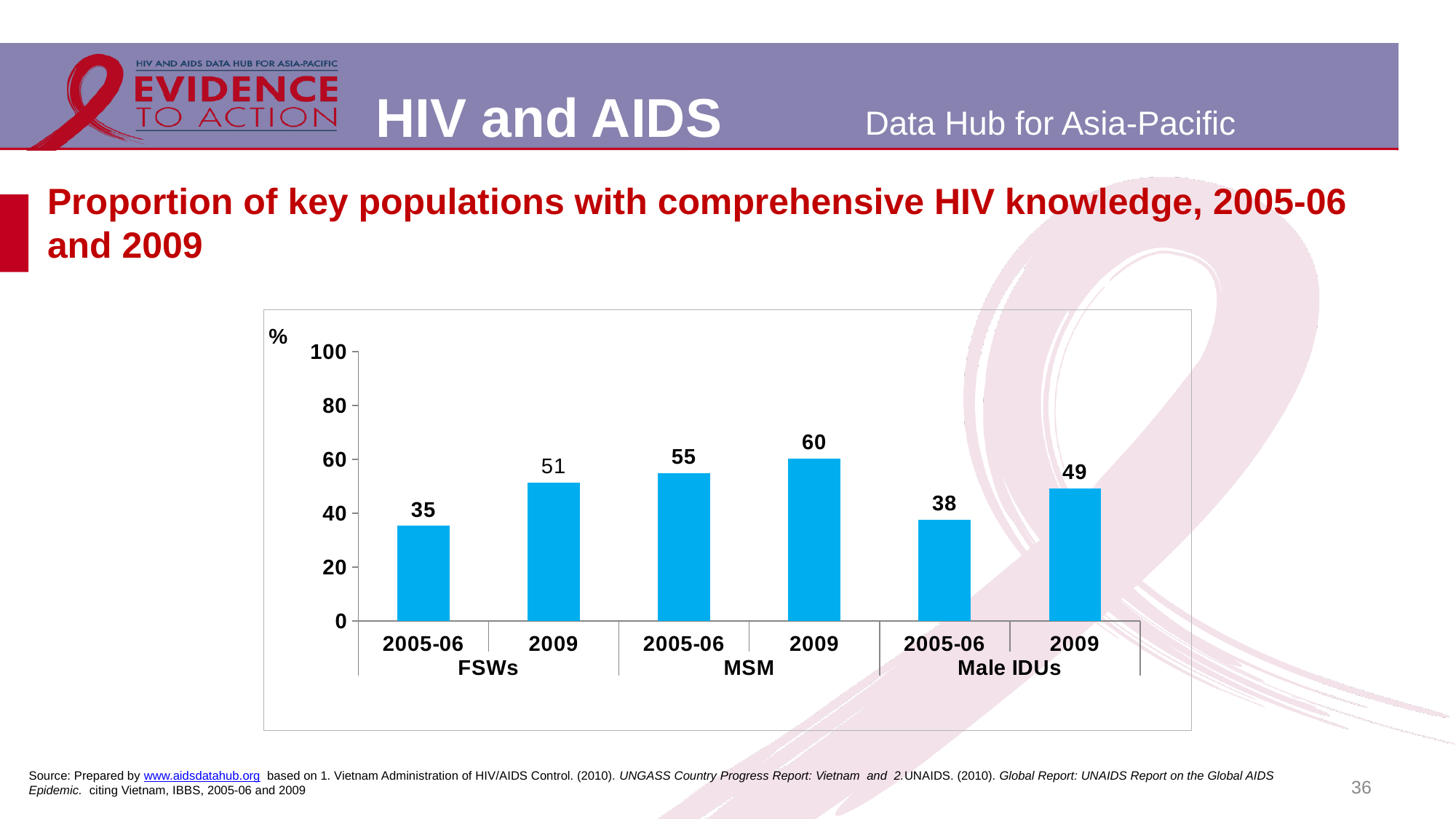
What is the value for Male IDUs in 2005-06? 38 Which bar has the highest value? MSM 2009 What is the difference between the 2009 and 2005-06 values for Male IDUs? 11 What unit is shown on the vertical axis of the chart? % What is the value for FSWs in 2009? 51 How many bars are plotted in the chart? 6 What is the value for FSWs in 2005-06? 35 What is the value for MSM in 2009? 60 What is the difference between the 2009 and 2005-06 values for FSWs? 16 Which is larger, the 2005-06 value for MSM or the 2009 value for Male IDUs? 2005-06 value for MSM What kind of chart is shown on the slide? Bar chart Which bar has the lowest value? FSWs 2005-06